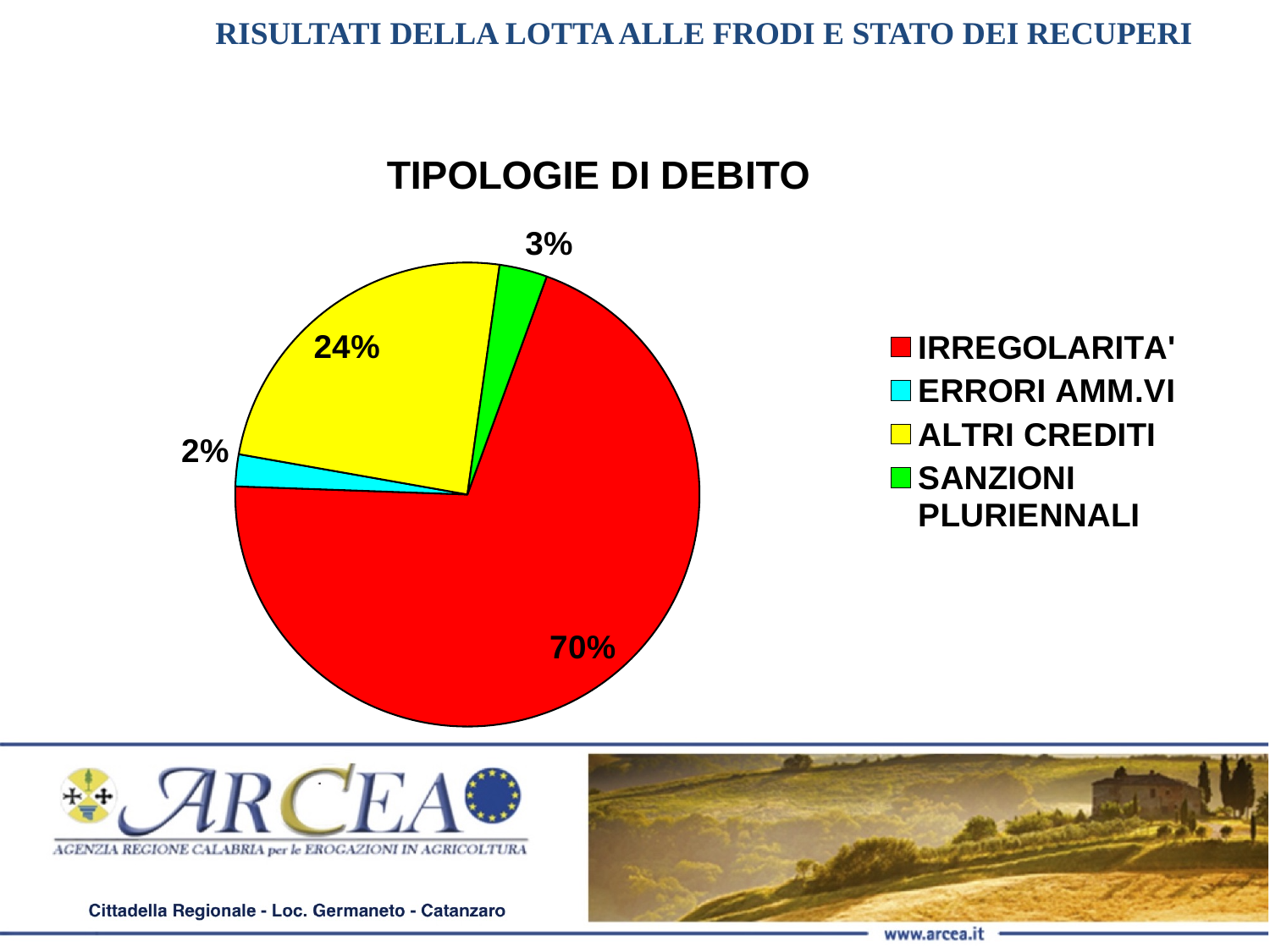
What share of the pie does ALTRI CREDITI represent? 24% What is the difference between the shares of IRREGOLARITA' and ALTRI CREDITI? 46% How many categories does the legend list? 4 Which is larger, the share for SANZIONI PLURIENNALI or the share for ERRORI AMM.VI? SANZIONI PLURIENNALI What share of the pie does IRREGOLARITA' represent? 70% What share of the pie does SANZIONI PLURIENNALI represent? 3% Which category has the smallest slice of the pie? ERRORI AMM.VI What is the title of the chart? TIPOLOGIE DI DEBITO What colour is the slice for ALTRI CREDITI? yellow What type of chart is shown on the slide? pie chart Which category has the largest slice of the pie? IRREGOLARITA'